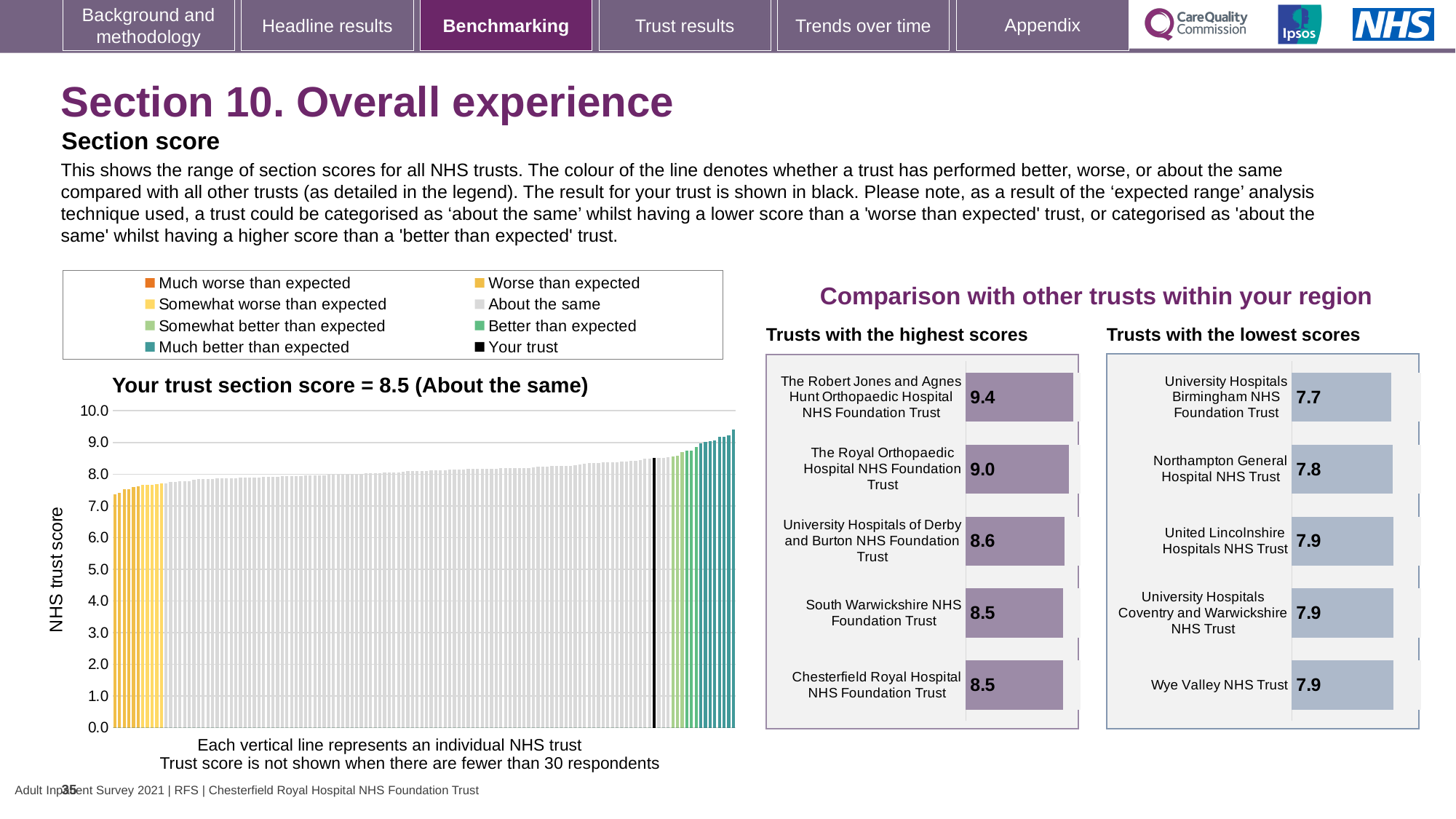
On the 'Your trust section score' chart, how many entries does the legend list? 8 On the 'Trusts with the lowest scores' chart, which trust has the lowest score? University Hospitals Birmingham NHS Foundation Trust On the 'Trusts with the highest scores' chart, how many trusts are listed? 5 On the 'Your trust section score' chart, what is the label on the vertical axis? NHS trust score On the 'Your trust section score' chart, what kind of chart is shown? bar chart On the 'Your trust section score' chart, do the bar heights rise or fall from left to right? rise On the 'Trusts with the lowest scores' chart, which has the larger score: Northampton General Hospital NHS Trust or University Hospitals Birmingham NHS Foundation Trust? Northampton General Hospital NHS Trust On the 'Your trust section score' chart, what is the section score for your trust? 8.5 On the 'Trusts with the highest scores' chart, what is the difference between the scores of The Robert Jones and Agnes Hunt Orthopaedic Hospital NHS Foundation Trust and University Hospitals of Derby and Burton NHS Foundation Trust? 0.8 On the 'Trusts with the highest scores' chart, what is the score for The Royal Orthopaedic Hospital NHS Foundation Trust? 9.0 On the 'Your trust section score' chart, is the value of the leftmost bar greater or less than 8.0? less On the 'Trusts with the highest scores' chart, which trust has the highest score? The Robert Jones and Agnes Hunt Orthopaedic Hospital NHS Foundation Trust